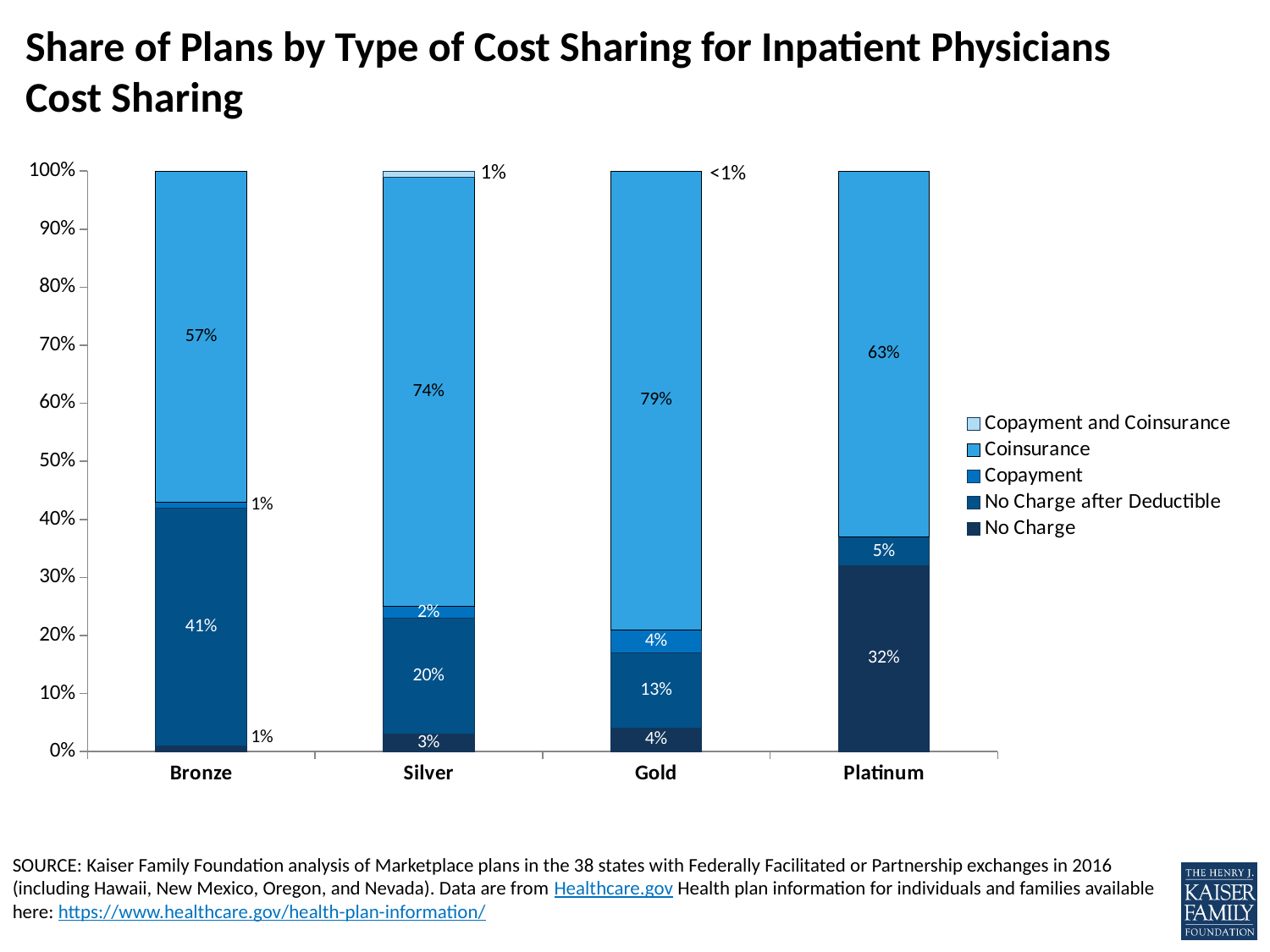
How many metal levels are shown on the x axis? 4 Which metal level has the lowest share of plans using Coinsurance? Bronze What kind of chart is shown on the slide? Stacked bar chart What share of Silver plans use Copayment and Coinsurance? 1% What share of Platinum plans have No Charge for inpatient physicians? 32% What share of Gold plans use Coinsurance for inpatient physician cost sharing? 79% Which metal level has the highest share of plans with No Charge? Platinum How many percentage points higher is the Coinsurance share for Silver than for Bronze? 17 percentage points Which has a larger share of plans with No Charge after Deductible, Bronze or Silver? Bronze Which metal level has the highest share of plans using Coinsurance? Gold What share of Gold plans use No Charge after Deductible? 13% How many cost-sharing types does the legend list? 5